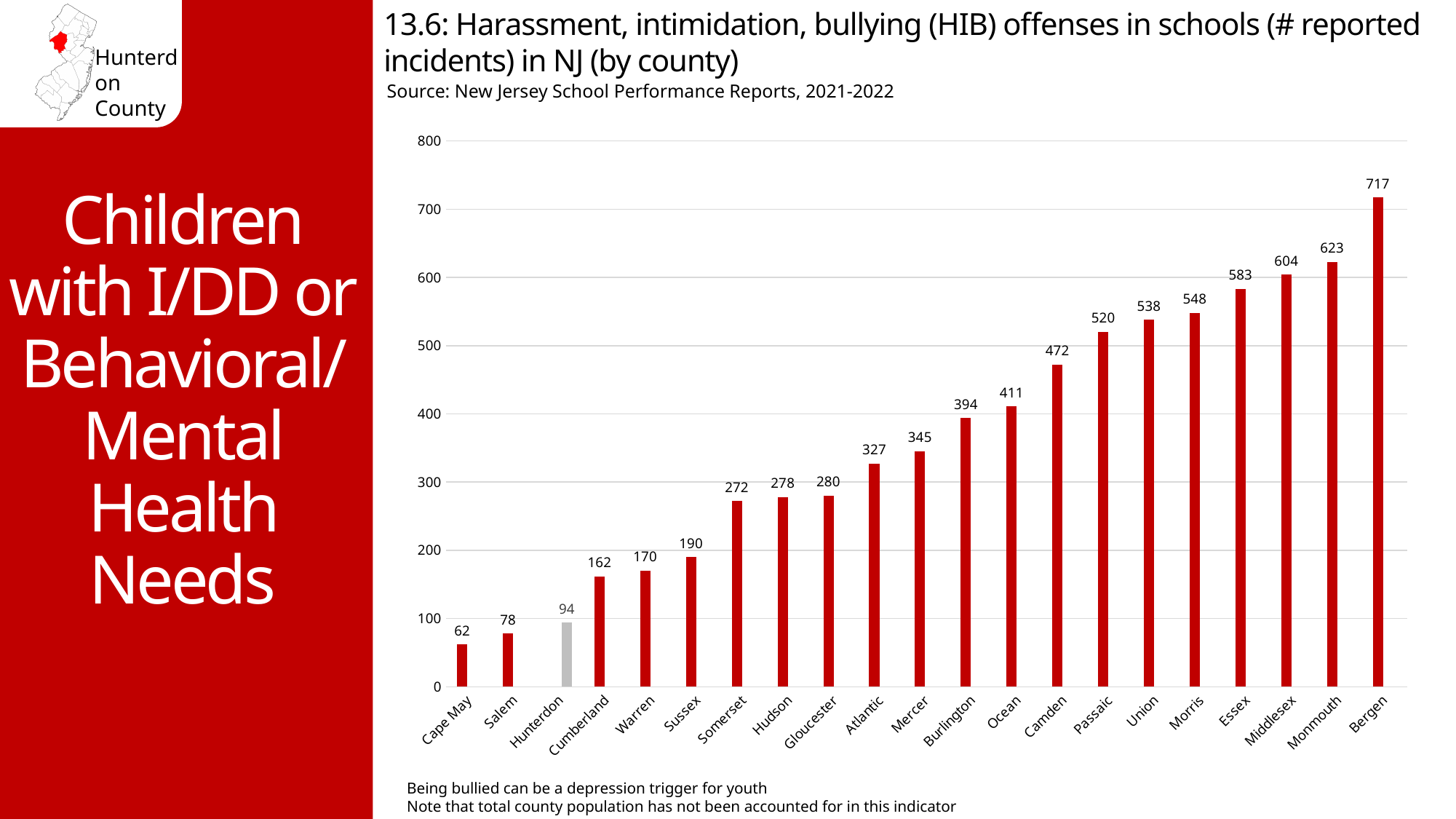
What is the difference between the values for Monmouth and Middlesex? 19 What is the value shown for Bergen? 717 What kind of chart is shown on the slide? Bar chart What is the value shown for Somerset? 272 Which county has the lowest number of reported HIB incidents? Cape May How many counties are shown on the x axis? 21 What is the difference between the values for Hunterdon and Cape May? 32 Is the value for Ocean greater or less than 400? greater Which county has the highest number of reported HIB incidents? Bergen How many reported HIB incidents does the chart show for Hunterdon? 94 Which county's bar is coloured grey instead of red? Hunterdon Which has a higher value, Passaic or Camden? Passaic